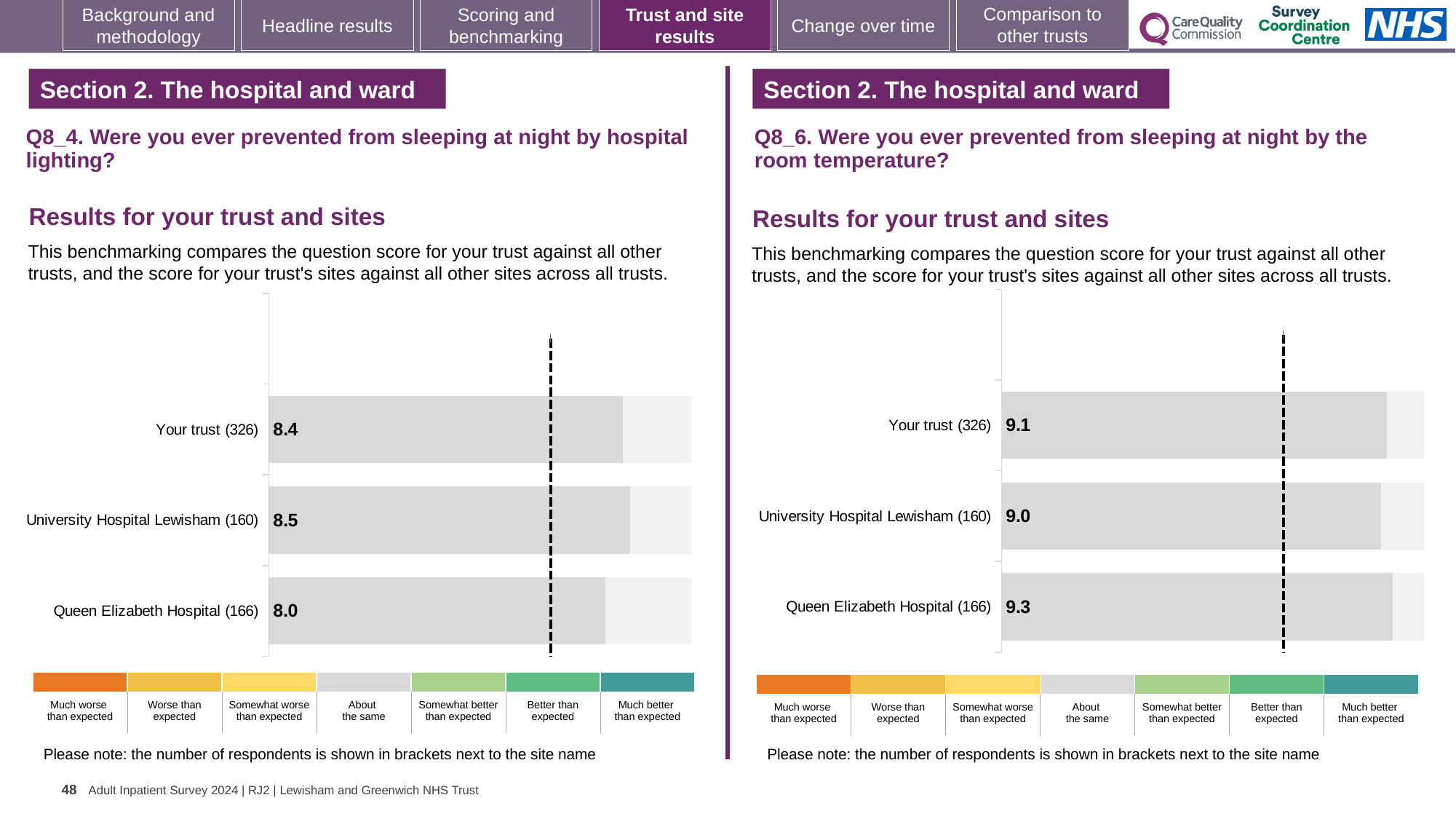
In the Q8_6 room temperature chart, which site or trust has the lowest score? University Hospital Lewisham (160) In the Q8_6 room temperature chart, what is the score for University Hospital Lewisham (160)? 9.0 In the Q8_4 hospital lighting chart, which site or trust has the highest score? University Hospital Lewisham (160) In the Q8_4 hospital lighting chart, what is the difference between the scores for University Hospital Lewisham (160) and Queen Elizabeth Hospital (166)? 0.5 How many bars are shown in the Q8_4 hospital lighting chart? 3 In the Q8_6 room temperature chart, what is the difference between the scores for Queen Elizabeth Hospital (166) and Your trust (326)? 0.2 In the Q8_6 room temperature chart, what is the score for Your trust (326)? 9.1 In the Q8_6 room temperature chart, which site or trust has the highest score? Queen Elizabeth Hospital (166) In the Q8_4 hospital lighting chart, which site or trust has the lowest score? Queen Elizabeth Hospital (166) What kind of chart is used in the Q8_6 room temperature chart? Bar chart In the Q8_4 hospital lighting chart, what is the score for Queen Elizabeth Hospital (166)? 8.0 In the Q8_4 hospital lighting chart, what is the score for Your trust (326)? 8.4